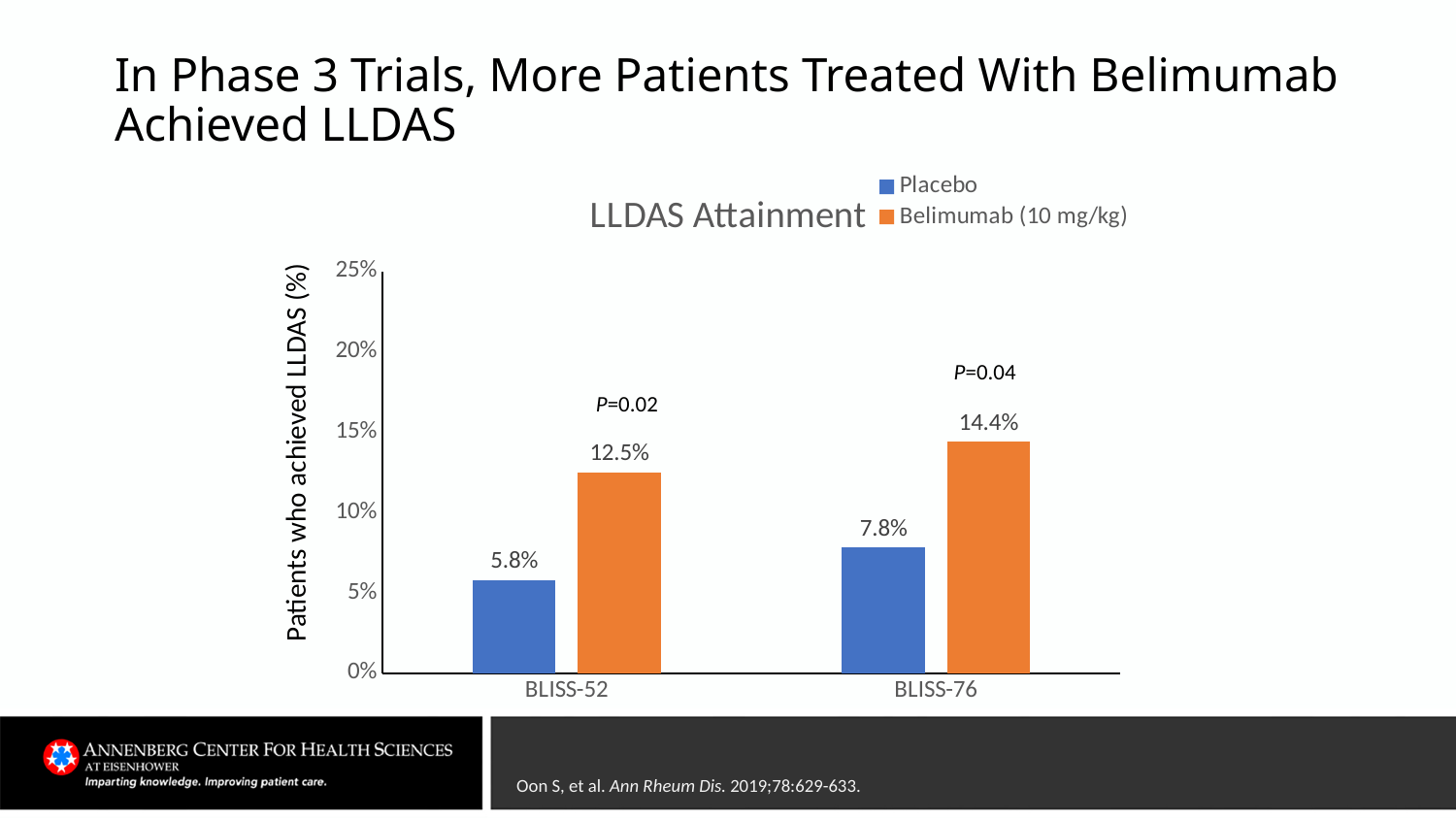
What percentage of placebo patients achieved LLDAS in BLISS-52? 5.8% Which bar shows the lowest LLDAS attainment? Placebo in BLISS-52 What kind of chart is shown on the slide? Bar chart What percentage of patients treated with Belimumab (10 mg/kg) achieved LLDAS in BLISS-76? 14.4% What is the difference in LLDAS attainment between Belimumab (10 mg/kg) and placebo in BLISS-76? 6.6% How many series does the legend list? 2 Which trial and treatment combination has the highest LLDAS attainment? Belimumab (10 mg/kg) in BLISS-76 How many trials are shown on the x axis? 2 What is the P value shown for the BLISS-52 comparison? P=0.02 Which had higher LLDAS attainment in BLISS-76, placebo or Belimumab (10 mg/kg)? Belimumab (10 mg/kg) What is the difference in LLDAS attainment between Belimumab (10 mg/kg) and placebo in BLISS-52? 6.7% What percentage of placebo patients achieved LLDAS in BLISS-76? 7.8%